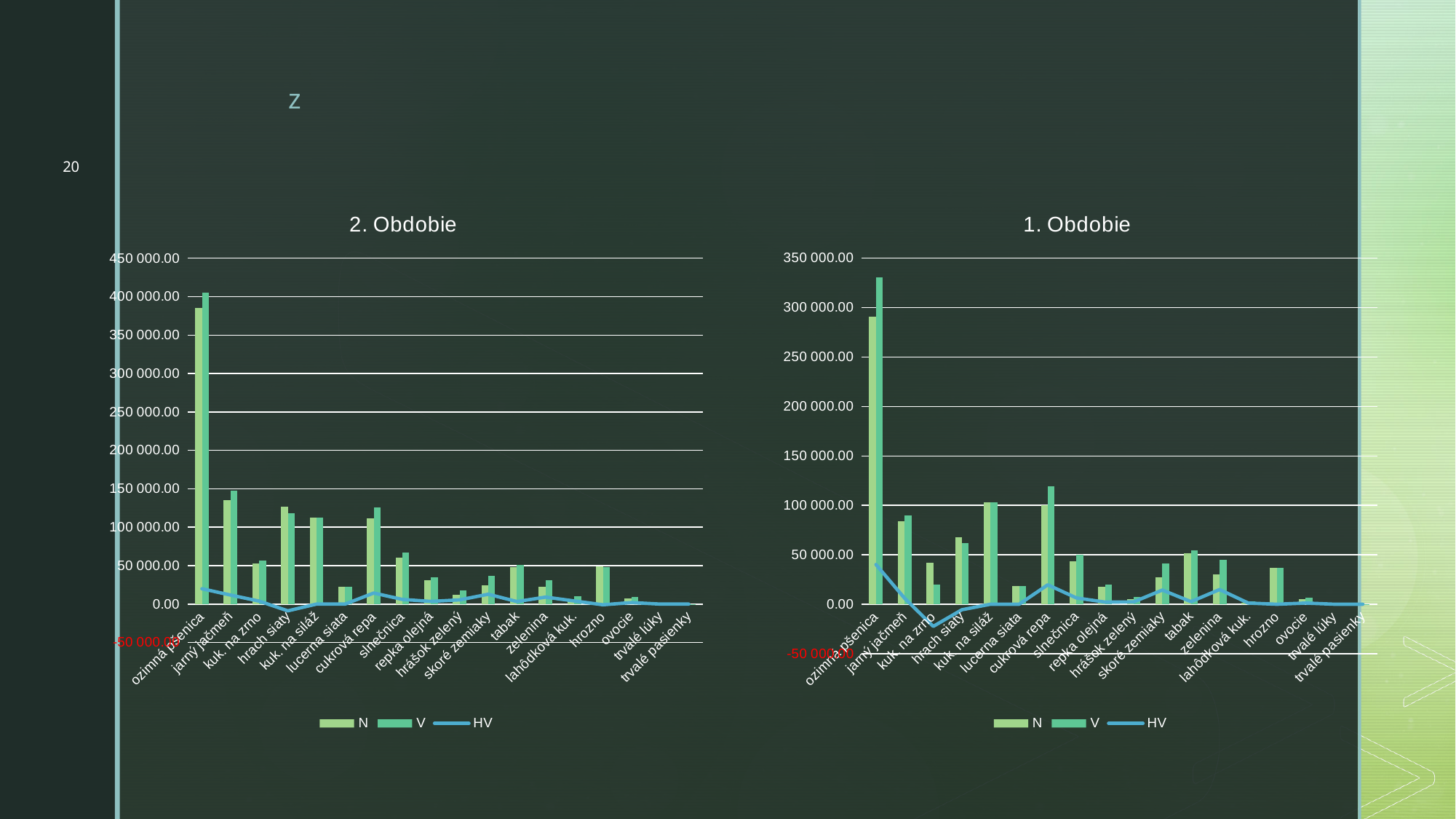
In the "1. Obdobie" chart, is the V value for ozimná pšenica greater or less than 300 000.00? greater What type of chart is the "2. Obdobie" chart? Bar chart with a line series What is the highest value shown on the y axis of the "2. Obdobie" chart? 450 000.00 In the "1. Obdobie" chart, which is larger for cukrová repa, the N value or the V value? V How many series does the legend of the "1. Obdobie" chart list? 3 In the "2. Obdobie" chart, is the N value for ozimná pšenica greater or less than 350 000.00? greater How many categories are shown on the x axis of the "2. Obdobie" chart? 18 In the "1. Obdobie" chart, which is larger for kuk. na zrno, the N value or the V value? N In the "1. Obdobie" chart, which category has the highest N value? ozimná pšenica In the "2. Obdobie" chart, which category has the highest V value? ozimná pšenica In the "1. Obdobie" chart, is the V value for jarný jačmeň greater or less than 100 000.00? less